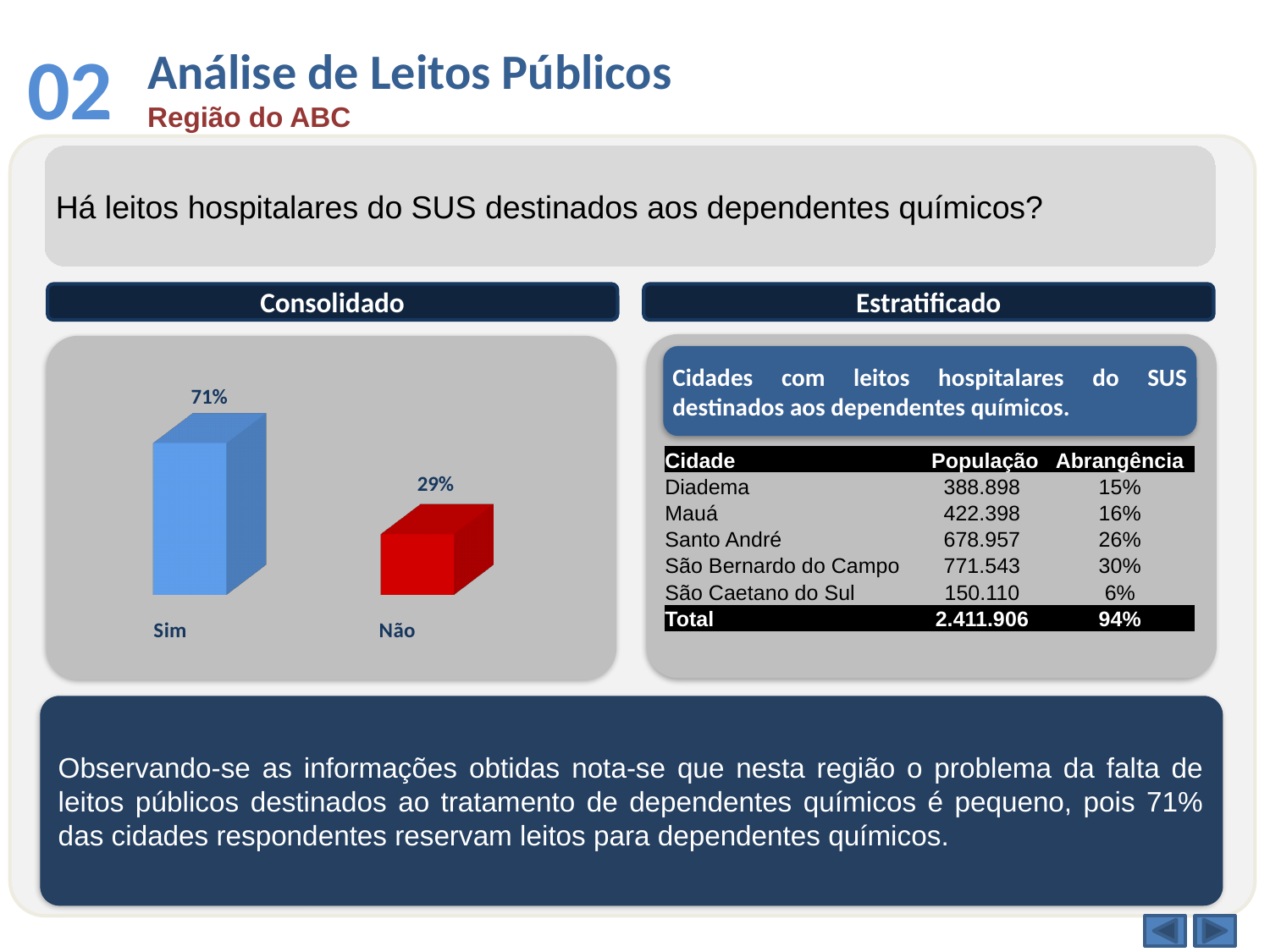
How many categories are shown in the Consolidado chart? 2 What is the difference between the values for "Sim" and "Não" in the Consolidado chart? 42% Which category has the highest value in the Consolidado chart? Sim What colour is the "Sim" bar in the Consolidado chart? Blue What kind of chart is the Consolidado chart? Bar chart What is the value for "Não" in the Consolidado chart? 29% In the Consolidado chart, which is larger: the value for "Sim" or the value for "Não"? Sim What is the value for "Sim" in the Consolidado chart? 71% What is the total of the two values shown in the Consolidado chart? 100% Which category has the lowest value in the Consolidado chart? Não What colour is the "Não" bar in the Consolidado chart? Red